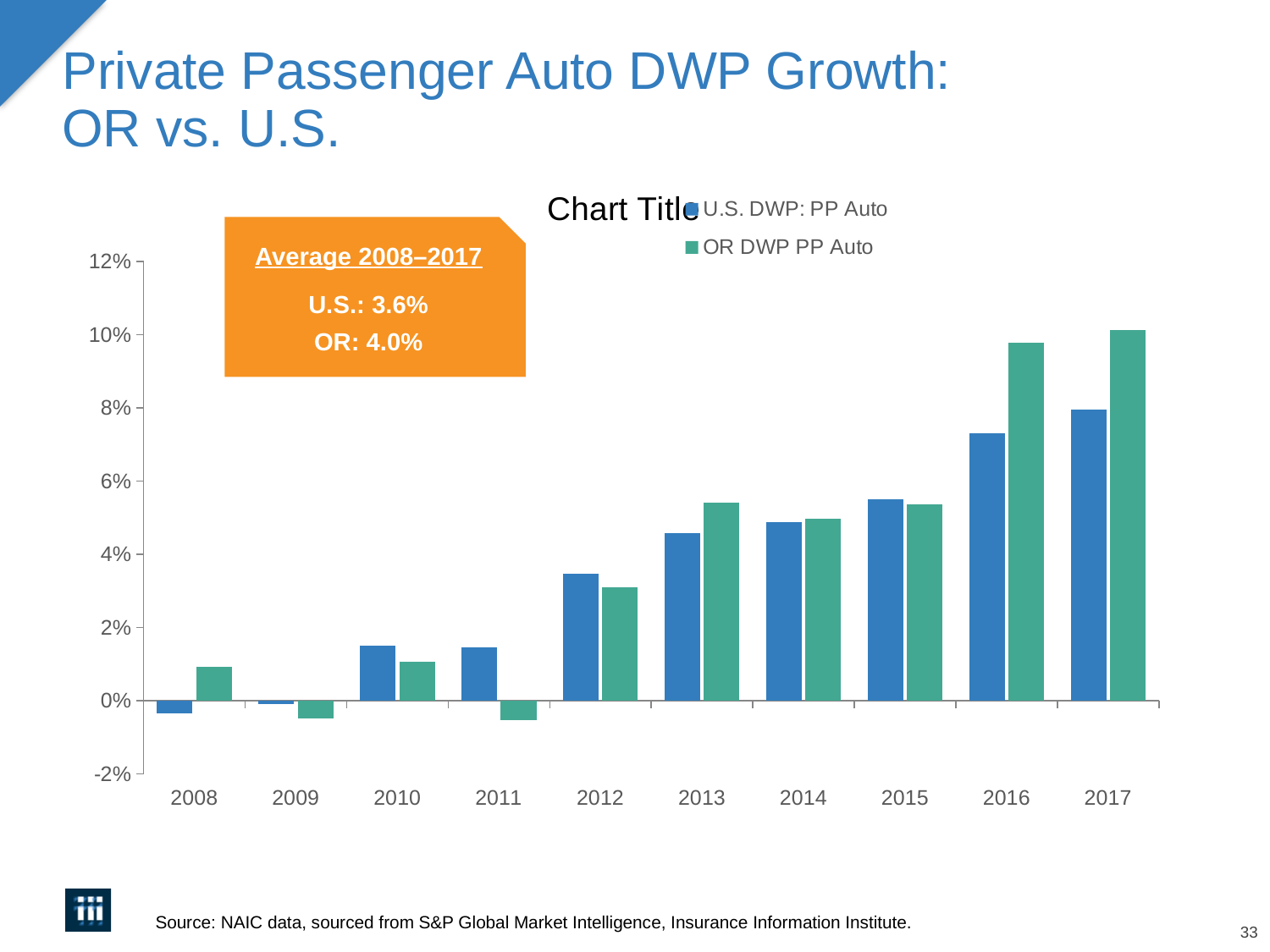
Do the U.S. DWP: PP Auto values rise or fall from 2012 to 2017? Rise Is the U.S. DWP: PP Auto value for 2012 greater or less than 2%? greater Is the U.S. DWP: PP Auto value for 2016 greater or less than 8%? less What kind of chart is shown on the slide? Bar chart In which year is the OR DWP PP Auto growth highest? 2017 In which year is the U.S. DWP: PP Auto growth highest? 2017 How many series does the chart legend list? 2 In 2013, which is larger: the U.S. DWP: PP Auto growth or the OR DWP PP Auto growth? OR DWP PP Auto How many years are shown on the x axis of the chart? 10 According to the text box on the chart, what is the average OR DWP growth for 2008–2017? 4.0% In 2011, which is larger: the U.S. DWP: PP Auto growth or the OR DWP PP Auto growth? U.S. DWP: PP Auto Is the OR DWP PP Auto value for 2016 greater or less than 8%? greater